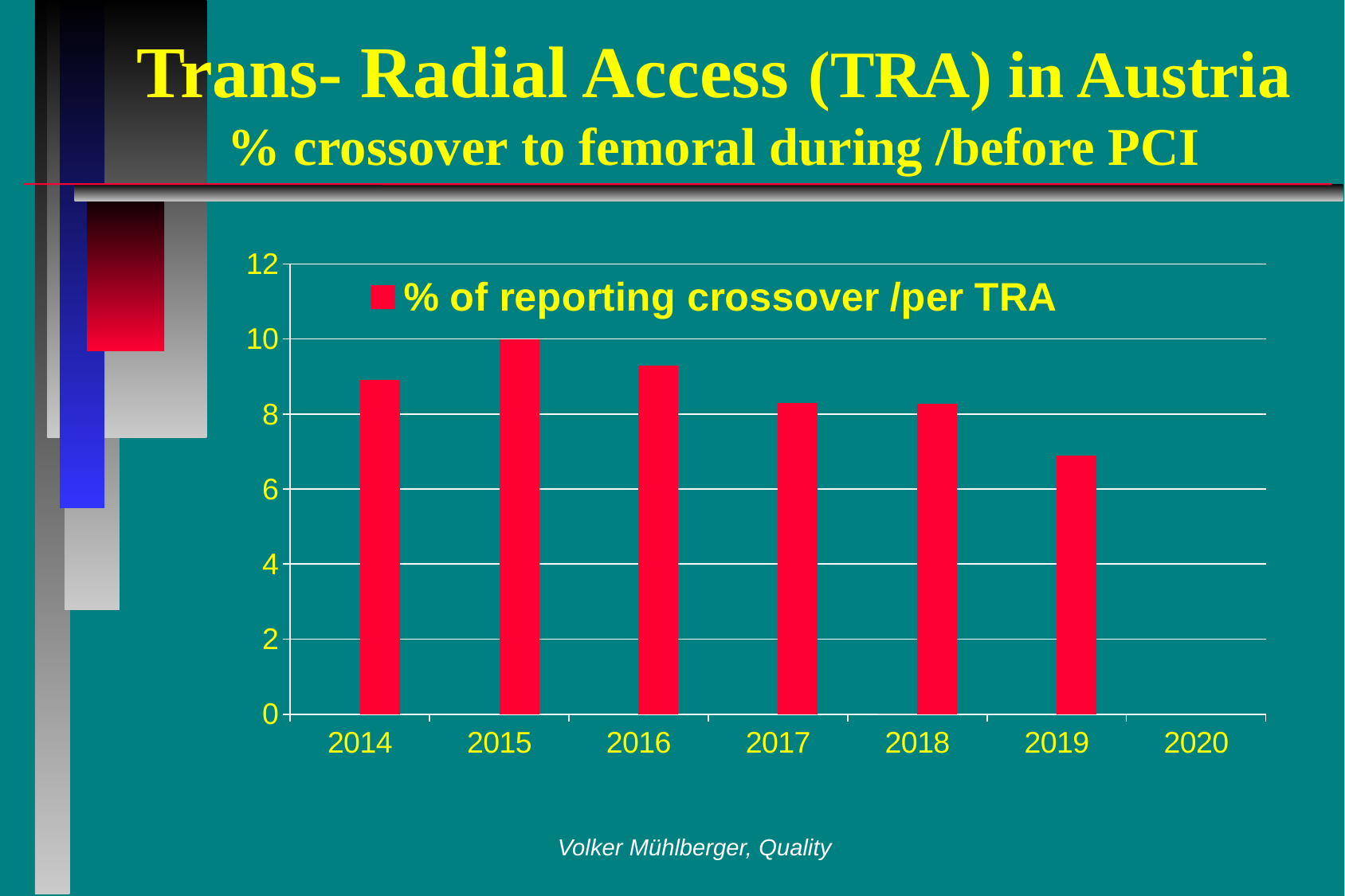
What is the legend entry for the series shown in the chart? % of reporting crossover /per TRA Do the values rise or fall from 2015 to 2019? fall Is the value for 2019 greater or less than 6? greater Among the years with a bar, which year has the lowest % of reporting crossover /per TRA? 2019 How many years are labelled on the x axis of the chart? 7 Which year has the larger value, 2014 or 2019? 2014 Which year has the highest % of reporting crossover /per TRA? 2015 Is the value for 2016 greater or less than 10? less What kind of chart is shown on the slide? bar chart How many series does the legend list? 1 Is the value for 2019 greater or less than 8? less